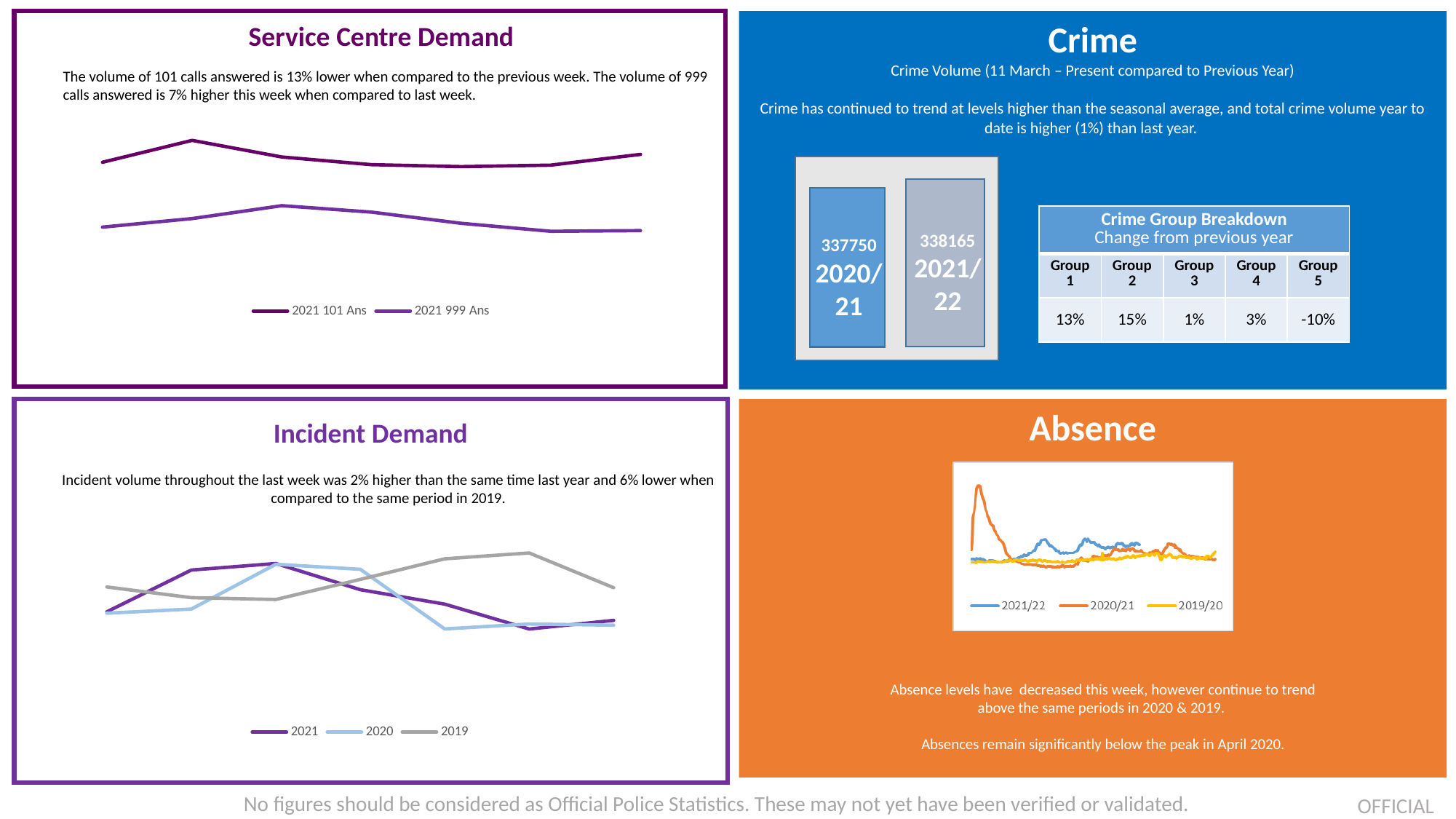
In the Crime bar chart, what is the value for 2020/21? 337750 How many series does the legend of the Service Centre Demand chart list? 2 In the Crime bar chart, what is the difference between the 2021/22 and 2020/21 values? 415 In the Service Centre Demand chart, which series is plotted higher, 2021 101 Ans or 2021 999 Ans? 2021 101 Ans In the Crime bar chart, which year has the higher value? 2021/22 How many bars are in the Crime bar chart? 2 What kind of chart is shown in the Service Centre Demand panel? line chart In the Incident Demand chart, which series is highest at the final point on the x axis? 2019 In the Absence chart, which series shows the large peak at the left of the chart? 2020/21 What kind of chart is shown in the Crime panel comparing 2020/21 and 2021/22? bar chart In the Crime bar chart, what is the value for 2021/22? 338165 How many series does the legend of the Incident Demand chart list? 3